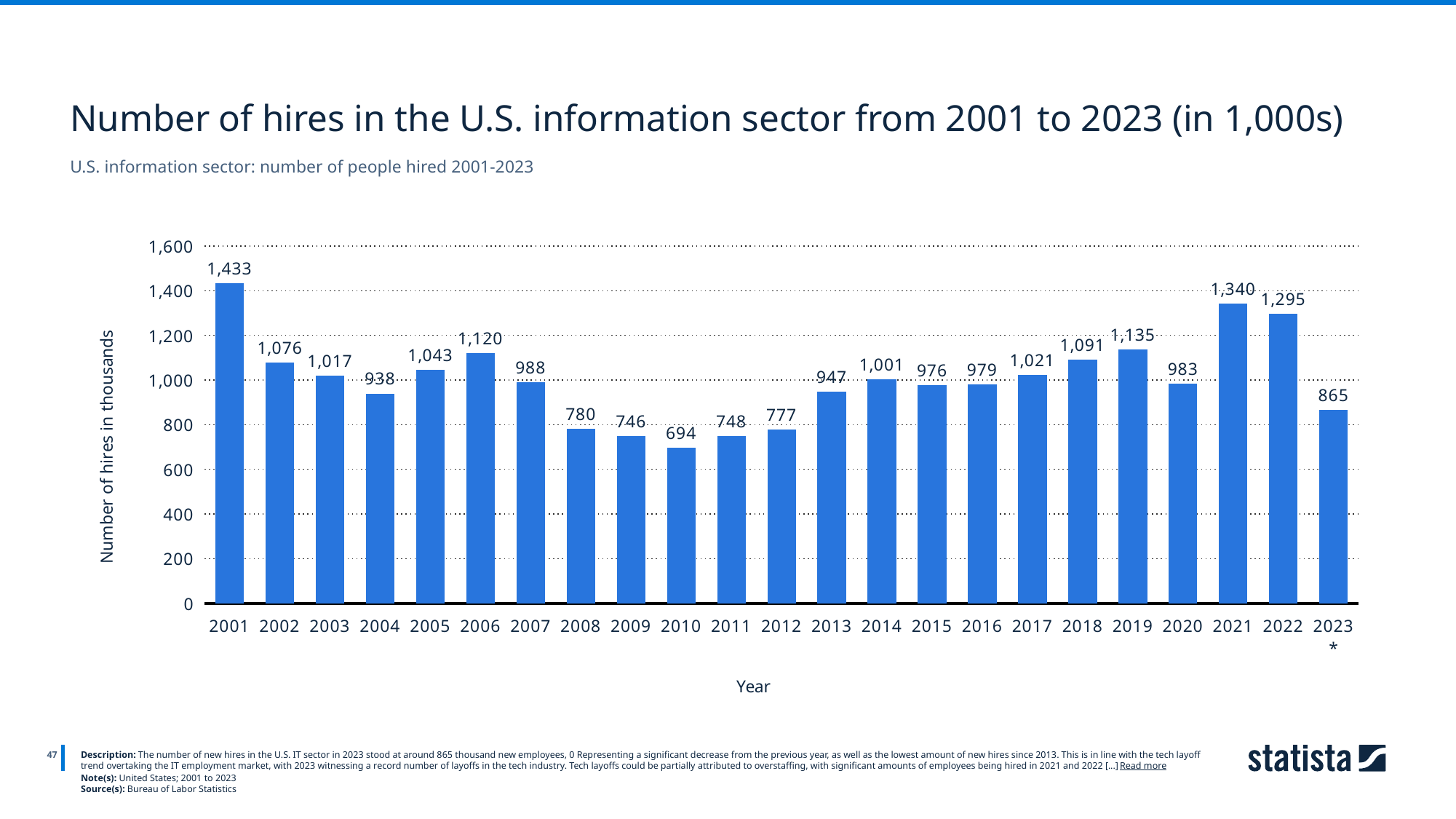
What was the number of hires in 2023? 865 Is the value for 2021 greater or less than 1,200? greater Did the number of hires rise or fall from 2010 to 2014? Rise Which year had the highest number of hires? 2001 What was the number of hires in the U.S. information sector in 2001? 1,433 Which year had the lowest number of hires? 2010 What was the number of hires in 2010? 694 What kind of chart is shown on the slide? Bar chart What is the difference in hires between 2022 and 2023? 430 Which year had more hires, 2006 or 2019? 2019 How many years are shown on the x axis? 23 What is the label of the y axis? Number of hires in thousands